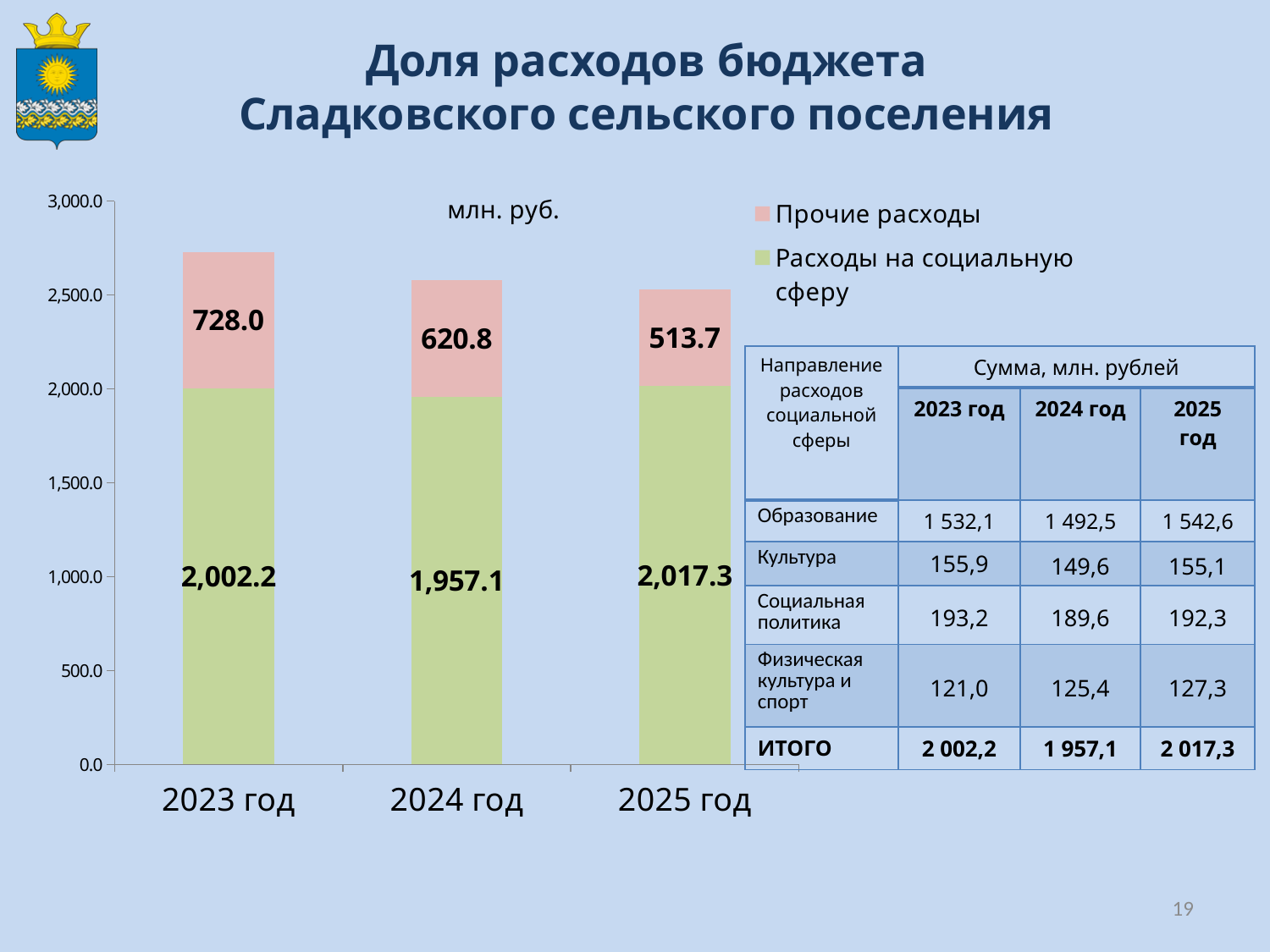
What is the total of the stacked bar for 2023 год? 2,730.2 What is the value of Прочие расходы for 2024 год? 620.8 Which year has the highest value for Прочие расходы? 2023 год What is the value of Расходы на социальную сферу for 2023 год? 2,002.2 What is the total of the stacked bar for 2025 год? 2,531.0 What kind of chart is shown on the slide? Stacked bar chart What is the value of Прочие расходы for 2025 год? 513.7 Which year has the lowest value for Расходы на социальную сферу? 2024 год How many years are shown on the x axis of the chart? 3 Which is larger: Расходы на социальную сферу in 2025 год or in 2023 год? 2025 год What is the difference between Прочие расходы in 2023 год and 2025 год? 214.3 How many series does the chart legend list? 2